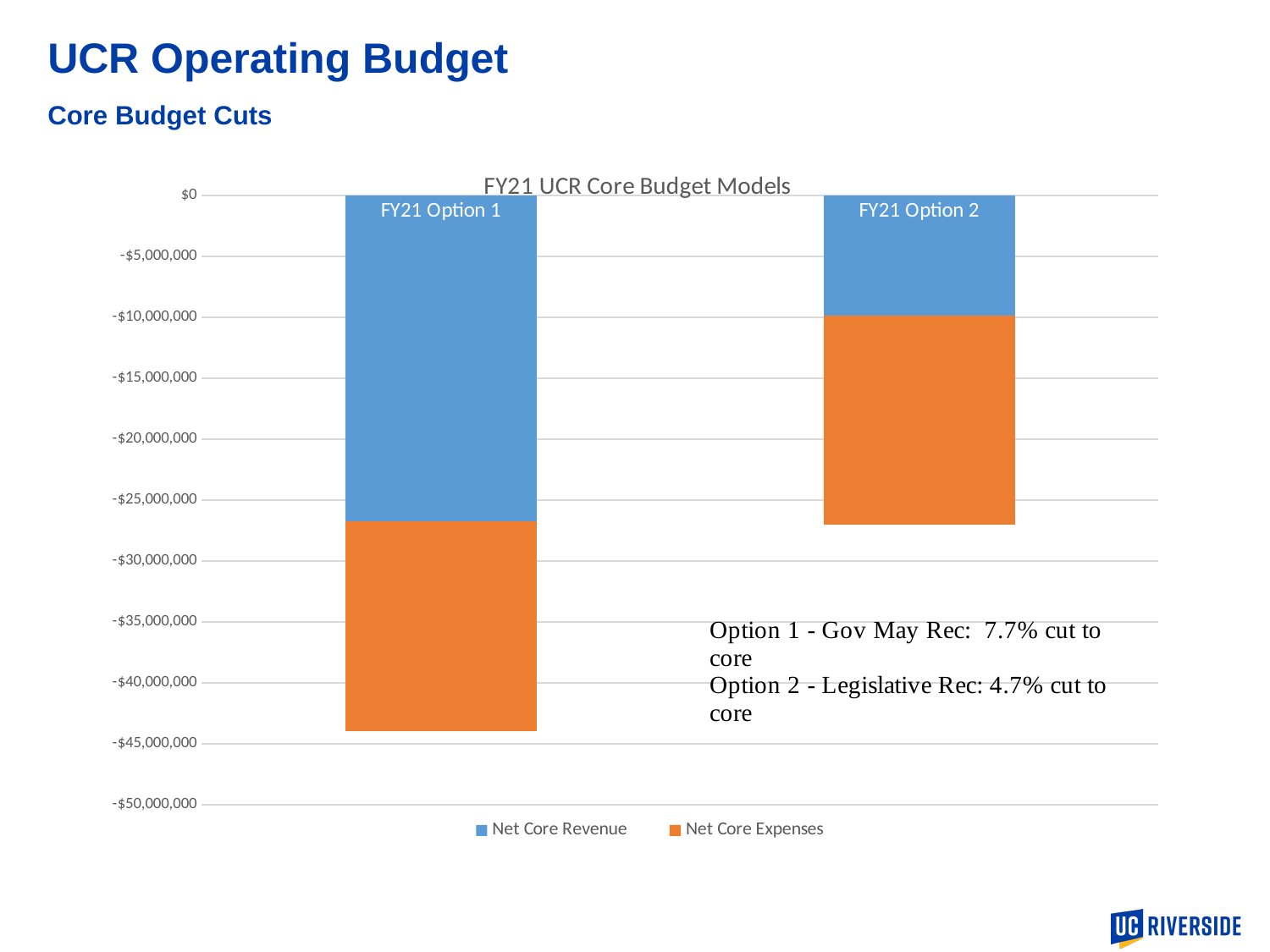
What are the two series named in the chart's legend? Net Core Revenue and Net Core Expenses What kind of chart is shown on the slide? bar chart How many categories are plotted on the x axis of the chart? 2 How many series does the chart's legend list? 2 Is the end of the Net Core Revenue segment for FY21 Option 1 greater or less than -$25,000,000? less What is the title of the chart? FY21 UCR Core Budget Models Which category has the longer stacked bar, FY21 Option 1 or FY21 Option 2? FY21 Option 1 Is the end of the Net Core Revenue segment for FY21 Option 2 greater or less than -$15,000,000? greater Is the bottom of the FY21 Option 1 stacked bar greater or less than -$40,000,000? less Which category has the longer Net Core Revenue segment, FY21 Option 1 or FY21 Option 2? FY21 Option 1